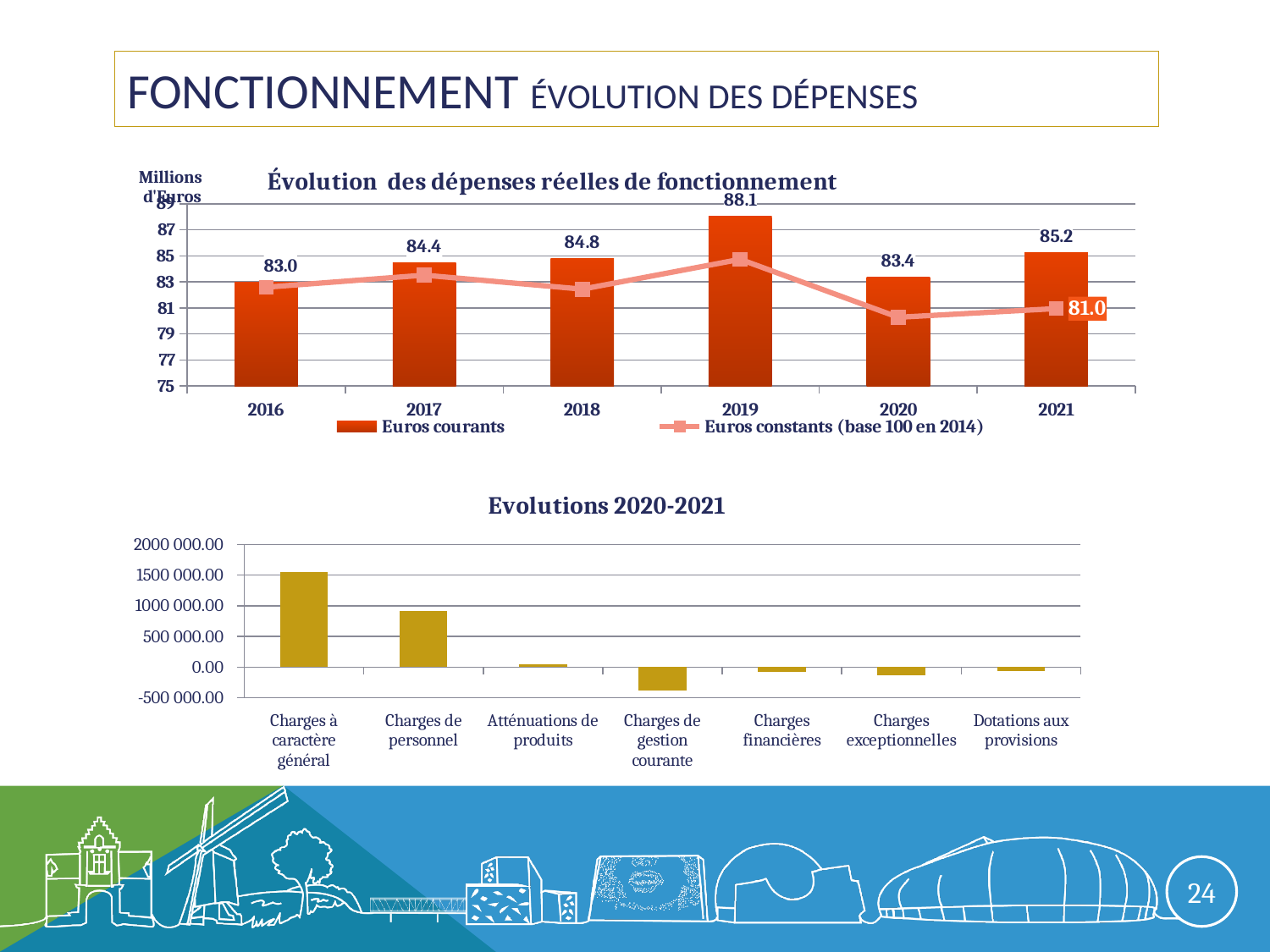
In the chart 'Évolution des dépenses réelles de fonctionnement', what is the labelled value of Euros constants (base 100 en 2014) for 2021? 81.0 In the chart 'Évolution des dépenses réelles de fonctionnement', what is the value of Euros courants for 2016? 83.0 In the chart 'Evolutions 2020-2021', which category has the highest value? Charges à caractère général In the chart 'Évolution des dépenses réelles de fonctionnement', what is the difference between the Euros courants values for 2019 and 2020? 4.7 In the chart 'Évolution des dépenses réelles de fonctionnement', how many years are shown on the x axis? 6 In the chart 'Évolution des dépenses réelles de fonctionnement', is the Euros courants value higher in 2021 or in 2018? 2021 In the chart 'Évolution des dépenses réelles de fonctionnement', how many series does the legend list? 2 In the chart 'Evolutions 2020-2021', how many categories are shown on the x axis? 7 In the chart 'Évolution des dépenses réelles de fonctionnement', what is the value of Euros courants for 2019? 88.1 In the chart 'Évolution des dépenses réelles de fonctionnement', which year has the lowest Euros courants value? 2016 In the chart 'Evolutions 2020-2021', is the value for Charges à caractère général greater or less than 1000 000.00? greater In the chart 'Évolution des dépenses réelles de fonctionnement', which year has the highest Euros courants value? 2019